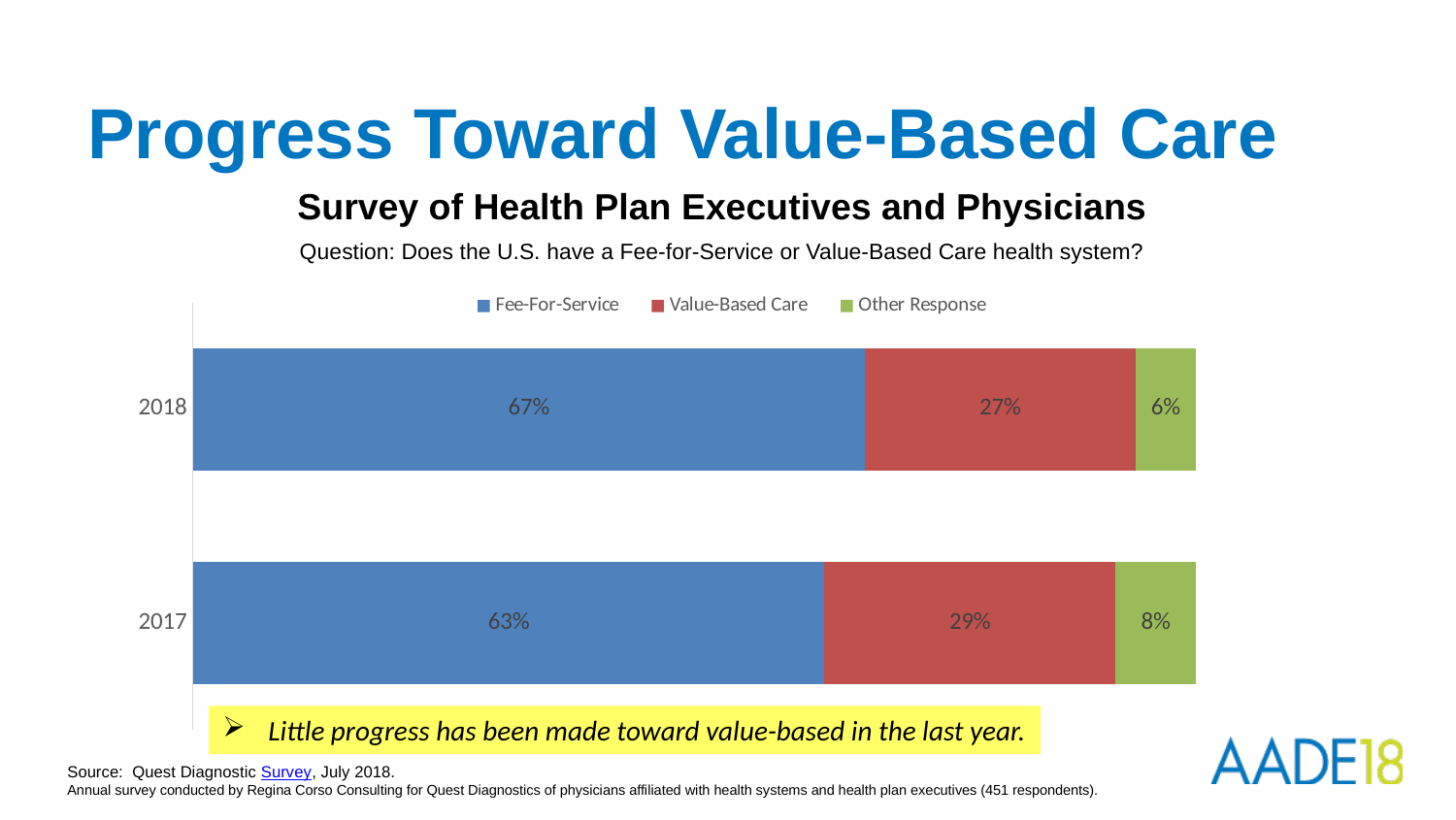
What is the Other Response value for 2018? 6% Which response category has the highest value in 2018? Fee-For-Service By how many percentage points did the Fee-For-Service share change from 2017 to 2018? 4 percentage points Which response category has the lowest value in 2017? Other Response What is the Fee-For-Service value for 2017? 63% How many series does the legend list? 3 What type of chart is shown on the slide? Stacked bar chart What percentage of respondents answered Value-Based Care in 2017? 29% How many years are shown on the chart? 2 What percentage of respondents answered Fee-For-Service in 2018? 67% What is the difference between the Value-Based Care values for 2017 and 2018? 2 percentage points Which year has the larger Other Response share, 2017 or 2018? 2017